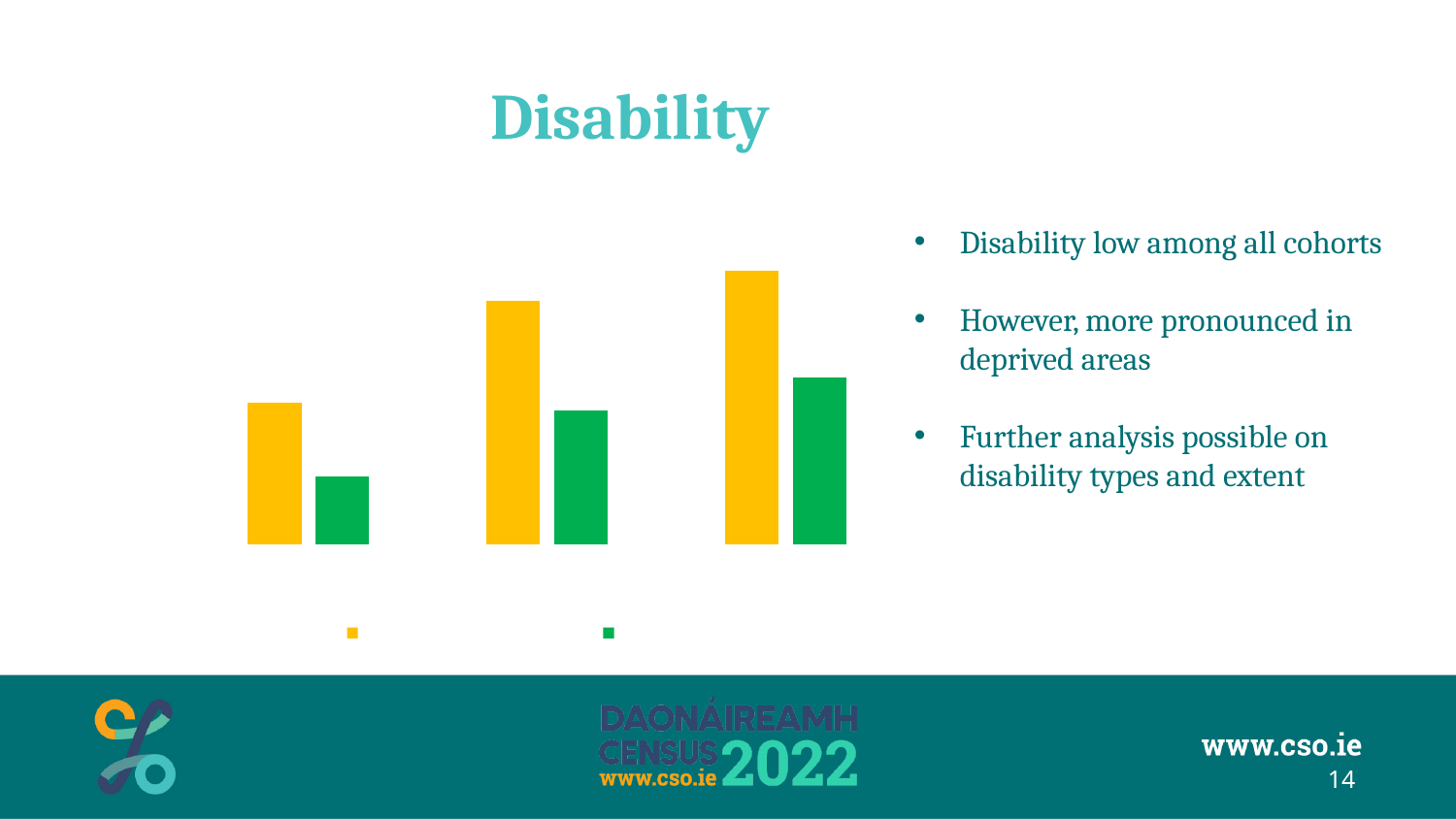
How many series does the chart's legend list? 2 What two colours are used for the bars in the chart? yellow and green How many groups of bars does the chart show? 3 Do the yellow bars rise or fall from left to right across the chart? rise In the rightmost group of bars, which bar is taller, the yellow one or the green one? the yellow one Which group of bars (leftmost, middle or rightmost) has the shortest green bar? leftmost Do the green bars rise or fall from left to right across the chart? rise Which group of bars (leftmost, middle or rightmost) has the tallest yellow bar? rightmost In the leftmost group of bars, which bar is taller, the yellow one or the green one? the yellow one What is the title of the slide containing the chart? Disability Which group of bars (leftmost, middle or rightmost) has the shortest yellow bar? leftmost What kind of chart is shown on the slide? bar chart